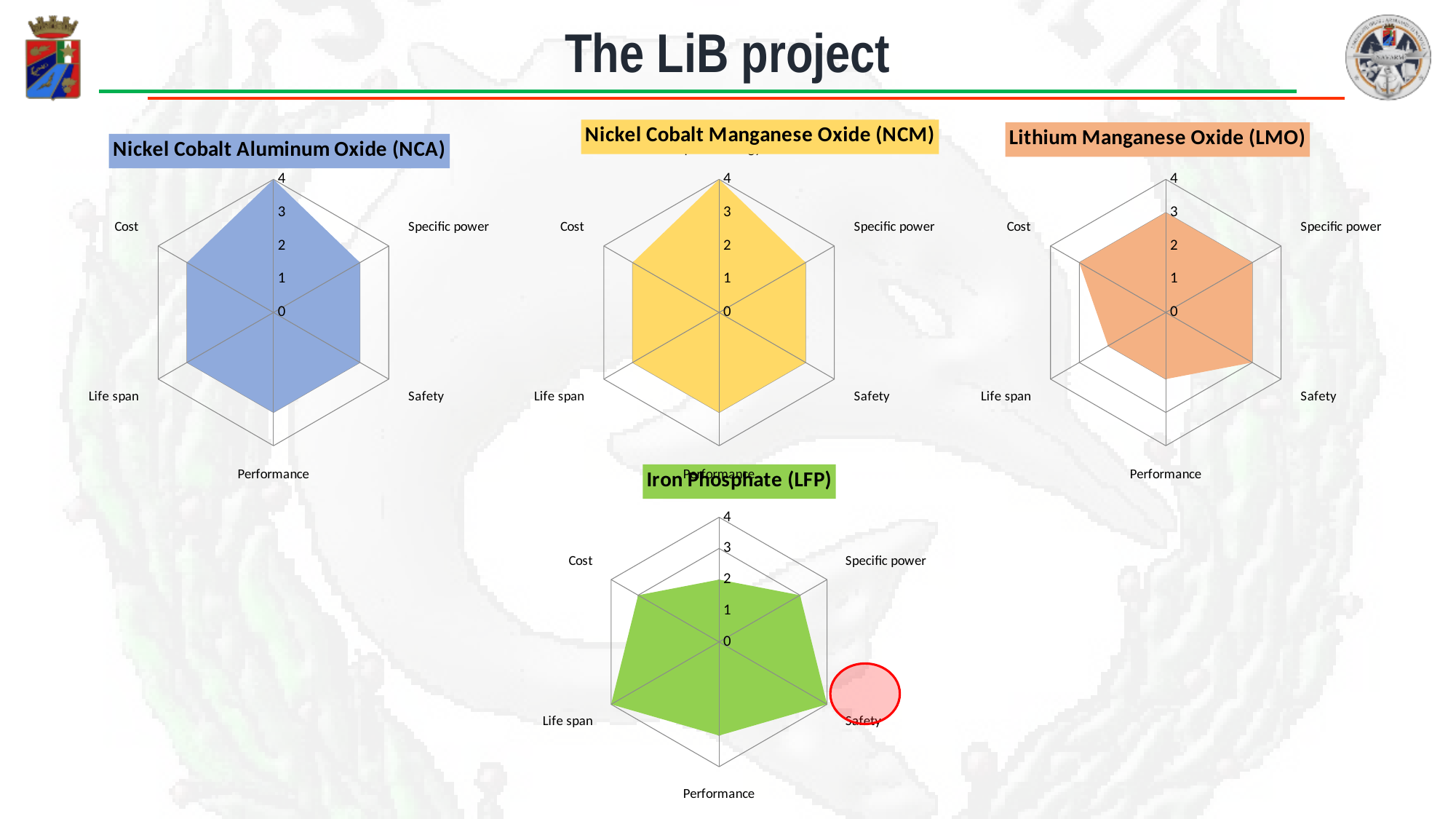
How many labelled axes (categories) does the Iron Phosphate (LFP) chart have? 6 What kind of chart is used for the Nickel Cobalt Aluminum Oxide (NCA) chart? Radar chart In the Nickel Cobalt Manganese Oxide (NCM) chart, what is the value for Cost? 3 In the Lithium Manganese Oxide (LMO) chart, which labelled category has the lowest value? Performance and Life span (both 2) In the Nickel Cobalt Aluminum Oxide (NCA) chart, what is the value for Safety? 3 In the Lithium Manganese Oxide (LMO) chart, what is the value for Performance? 2 In the Iron Phosphate (LFP) chart, is the value for Safety greater or less than 3? greater In the Lithium Manganese Oxide (LMO) chart, is the value for Performance greater or less than 3? less In the Iron Phosphate (LFP) chart, what is the value for Safety? 4 In the Iron Phosphate (LFP) chart, what is the value for Life span? 4 What is the maximum value shown on the axis scale of the Nickel Cobalt Manganese Oxide (NCM) chart? 4 Which is larger: the Safety value in the Iron Phosphate (LFP) chart or the Safety value in the Nickel Cobalt Aluminum Oxide (NCA) chart? Iron Phosphate (LFP)